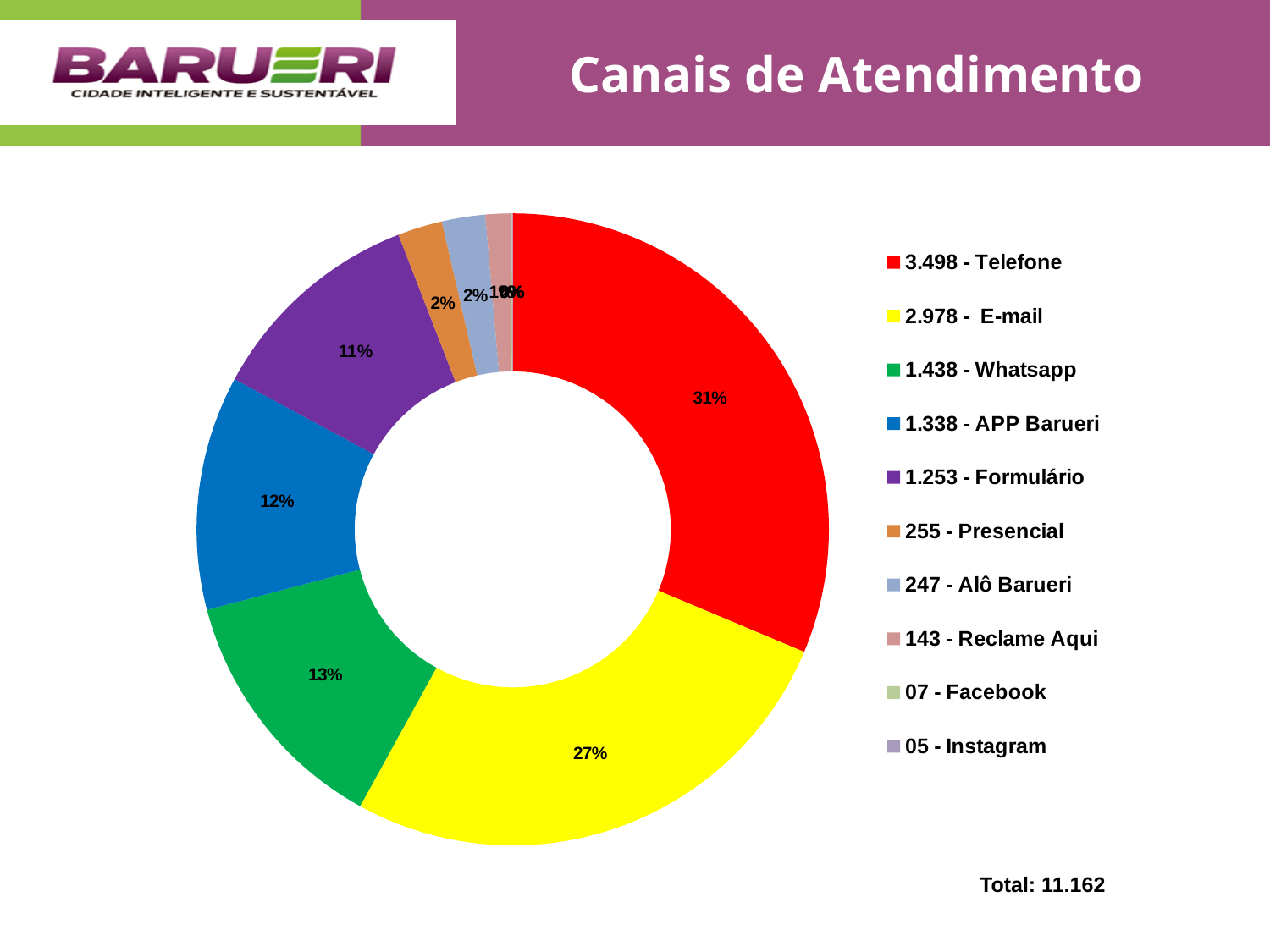
Which channel has the smallest value in the legend? Instagram What kind of chart is shown on the slide? doughnut chart What value is shown for Whatsapp in the legend? 1.438 What percentage share does the E-mail slice have? 27% What value is shown for Telefone in the legend? 3.498 What total is printed on the slide for all channels? 11.162 Which channel has the largest share of the chart? Telefone How many categories does the legend of the chart list? 10 Which is larger, the value for APP Barueri or the value for Formulário? APP Barueri What value is shown for Presencial in the legend? 255 What is the difference between the Telefone value and the E-mail value? 520 What percentage share does the Formulário slice have? 11%